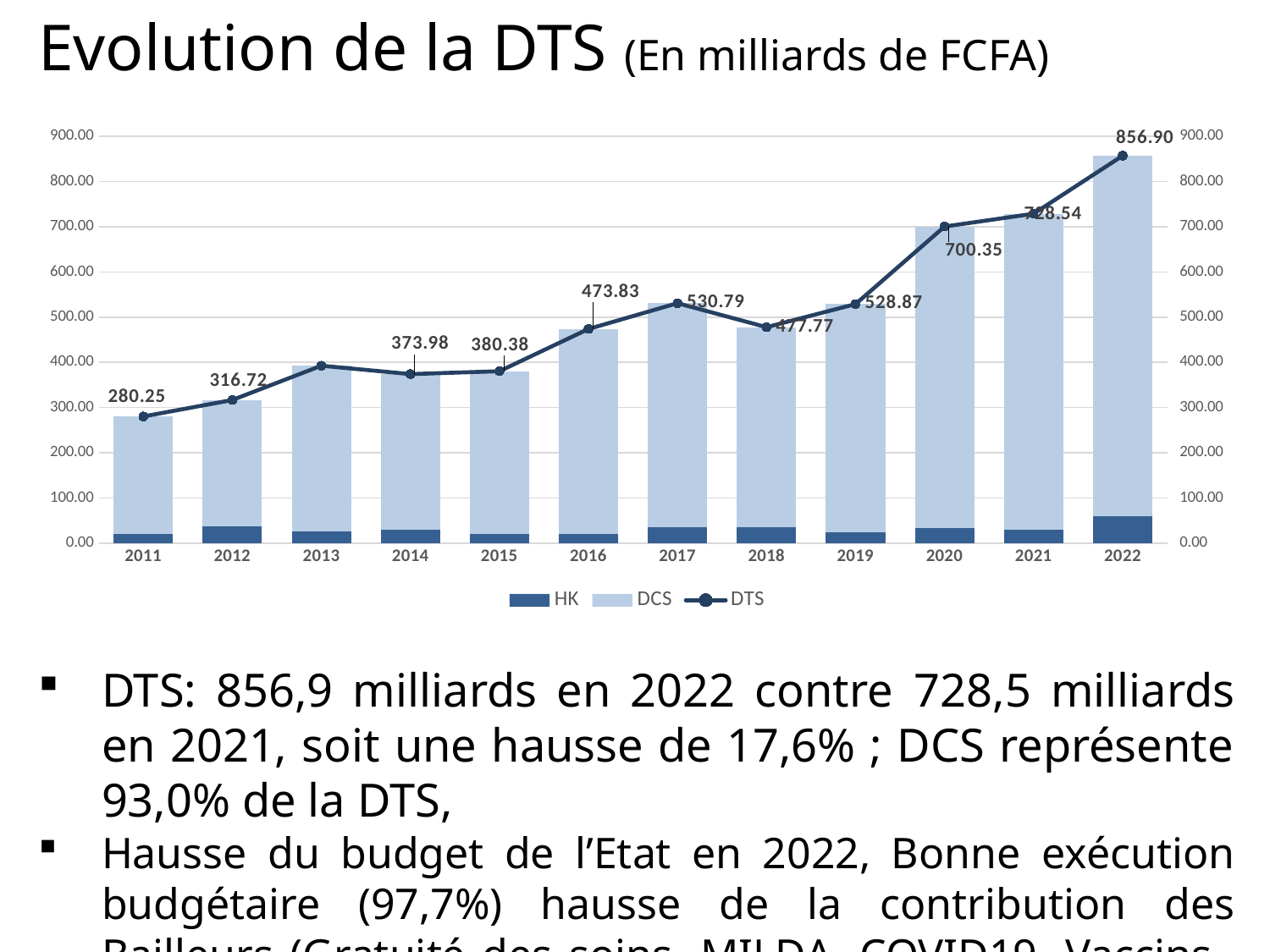
Which year has the highest DTS value? 2022 What is the difference between the DTS values for 2022 and 2021? 128.36 Which year has the lowest DTS value? 2011 How many years are shown on the x axis? 12 What is the DTS value for 2020? 700.35 What are the three series named in the legend? HK, DCS, DTS How many series does the legend list? 3 What is the DTS value for 2022? 856.90 Which year has a larger DTS value, 2017 or 2018? 2017 Is the HK value for 2022 greater or less than 100.00? less What is the DTS value for 2011? 280.25 What is the DTS value for 2018? 477.77